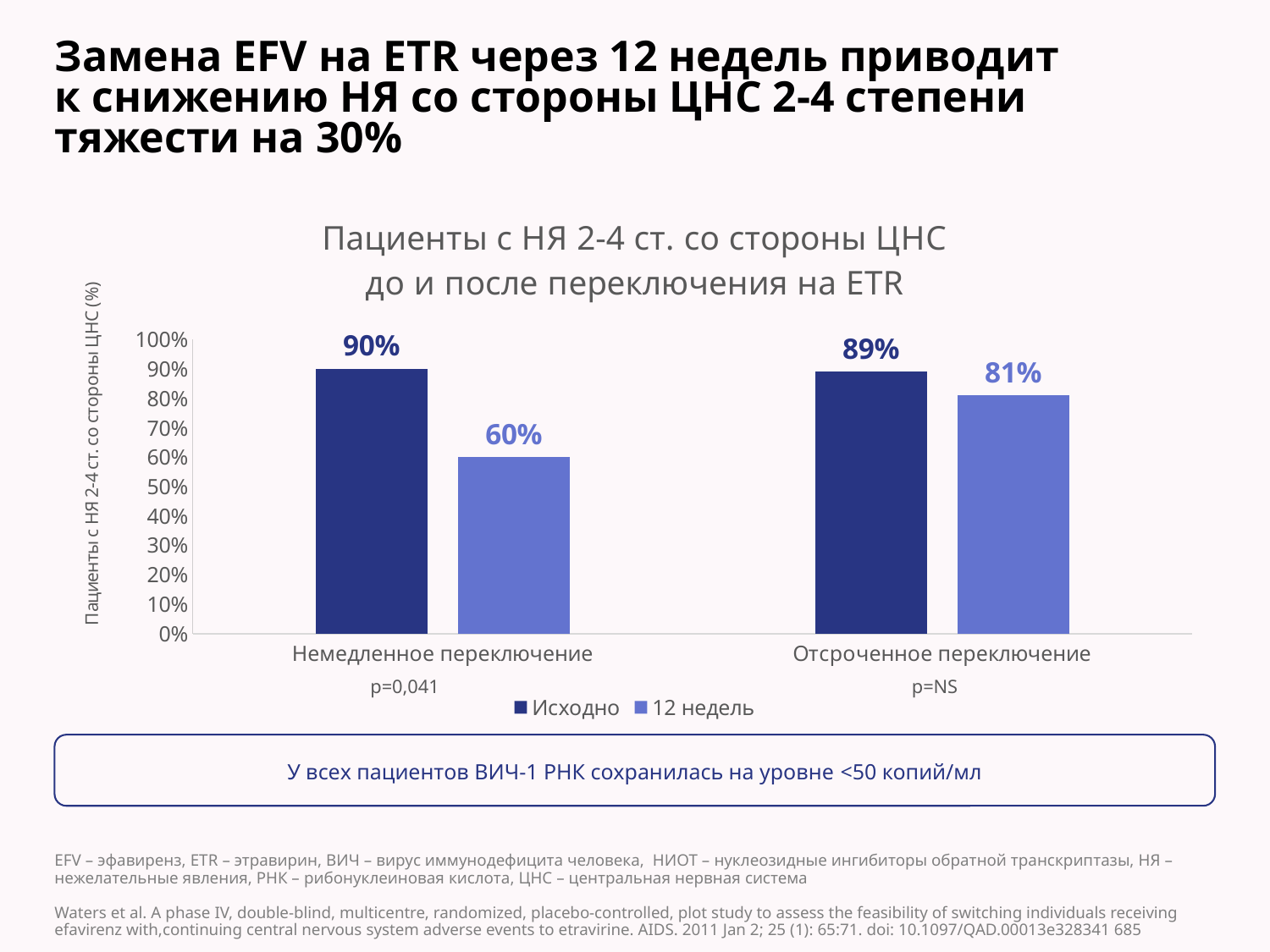
What is the difference between the "Исходно" and "12 недель" values in the "Отсроченное переключение" group? 8% What is the difference between the "Исходно" and "12 недель" values in the "Немедленное переключение" group? 30% What is the value for "12 недель" in the "Немедленное переключение" group? 60% Which bar has the lowest value on the chart? 12 недель, Немедленное переключение What kind of chart is shown on the slide? Bar chart How many categories are shown on the x axis? 2 What is the value for "12 недель" in the "Отсроченное переключение" group? 81% How many series does the legend list? 2 What is the value for "Исходно" in the "Немедленное переключение" group? 90% Which is larger: the "12 недель" value for "Немедленное переключение" or for "Отсроченное переключение"? Отсроченное переключение What is the value for "Исходно" in the "Отсроченное переключение" group? 89% What is the p-value shown under the "Немедленное переключение" group? p=0,041